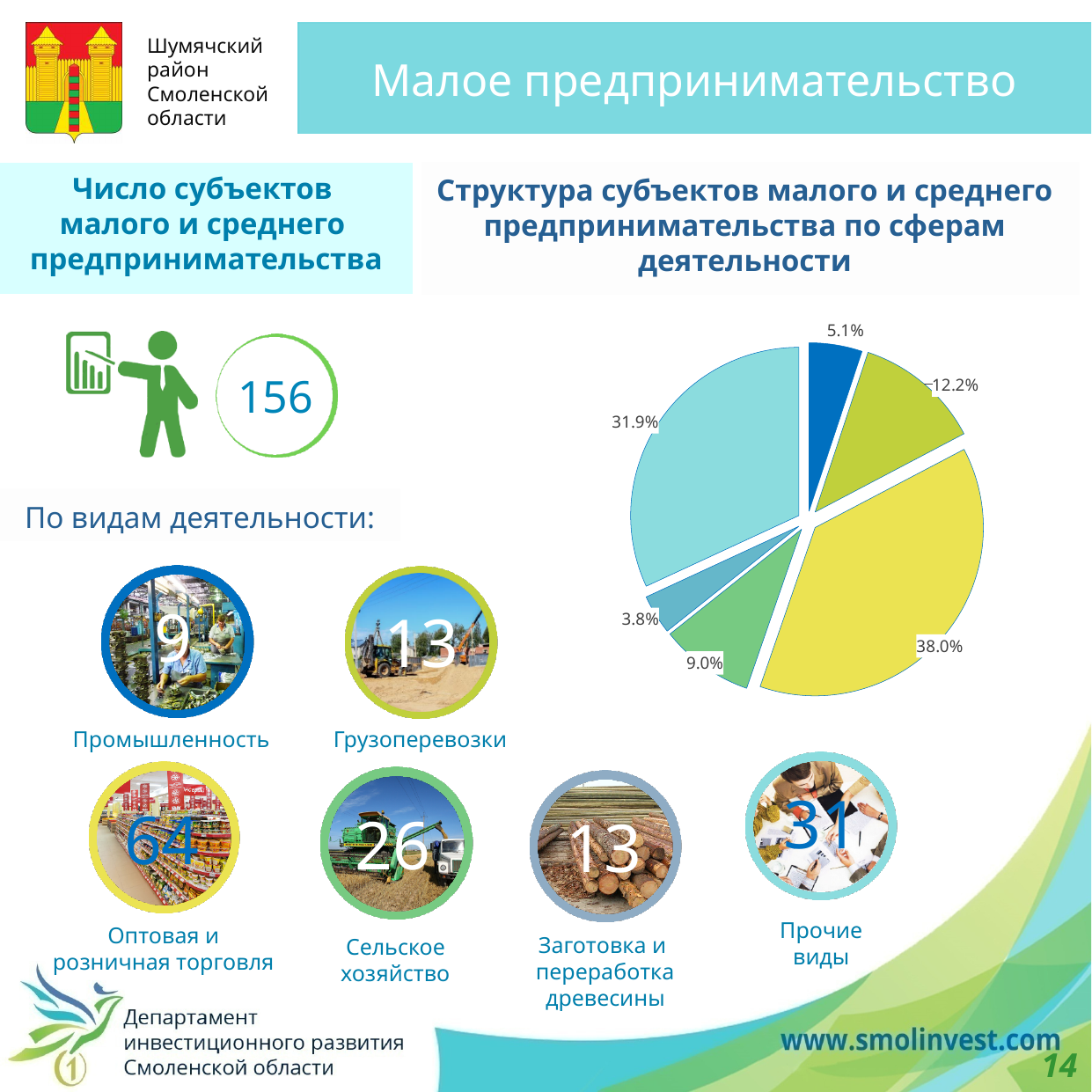
What is the combined share of the two slices labelled 5.1% and 12.2% in the pie chart? 17.3% What kind of chart is shown under the title "Структура субъектов малого и среднего предпринимательства по сферам деятельности"? pie chart What is the percentage of the smallest slice in the pie chart? 3.8% What is the title of the pie chart on the slide? Структура субъектов малого и среднего предпринимательства по сферам деятельности What colour is the largest slice (38.0%) of the pie chart? yellow Is the slice labelled 12.2% in the pie chart larger or smaller than the slice labelled 9.0%? larger What is the difference between the largest and smallest slices of the pie chart? 34.2% What is the percentage of the largest slice in the pie chart? 38.0% How many slices does the pie chart have? 6 Which is larger in the pie chart: the slice labelled 31.9% or the slice labelled 38.0%? 38.0% What is the percentage of the second-largest slice in the pie chart? 31.9%